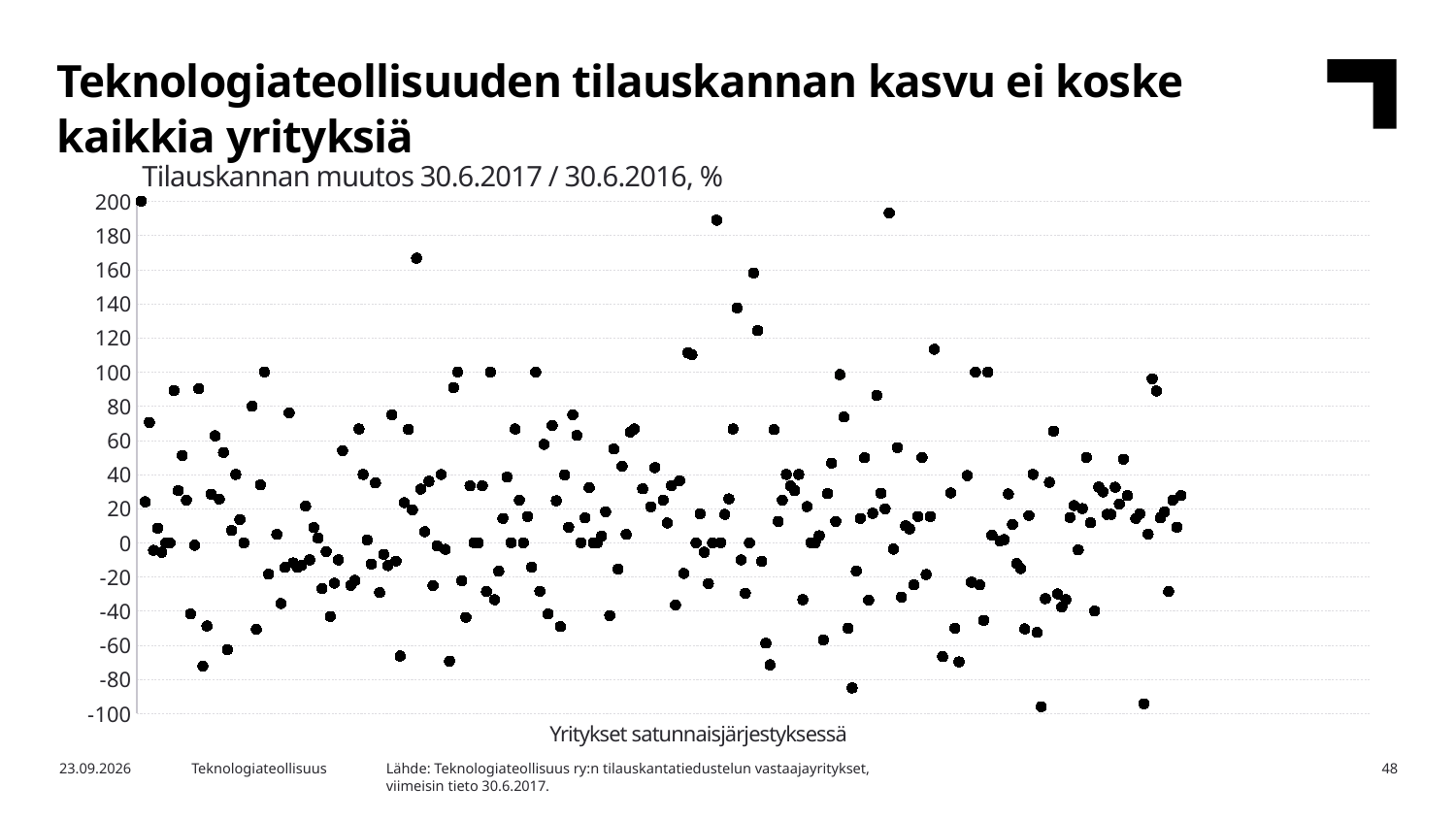
What is the title of the chart? Tilauskannan muutos 30.6.2017 / 30.6.2016, % What is the highest value shown on the y axis of the chart? 200 Are any plotted points below -80 on the y axis? Yes What is the label of the x axis of the chart? Yritykset satunnaisjärjestyksessä What kind of chart is shown on the slide? Scatter plot What is the lowest value shown on the y axis of the chart? -100 What is the interval between consecutive tick marks on the y axis? 20 Are most of the plotted points above or below 100 on the y axis? below